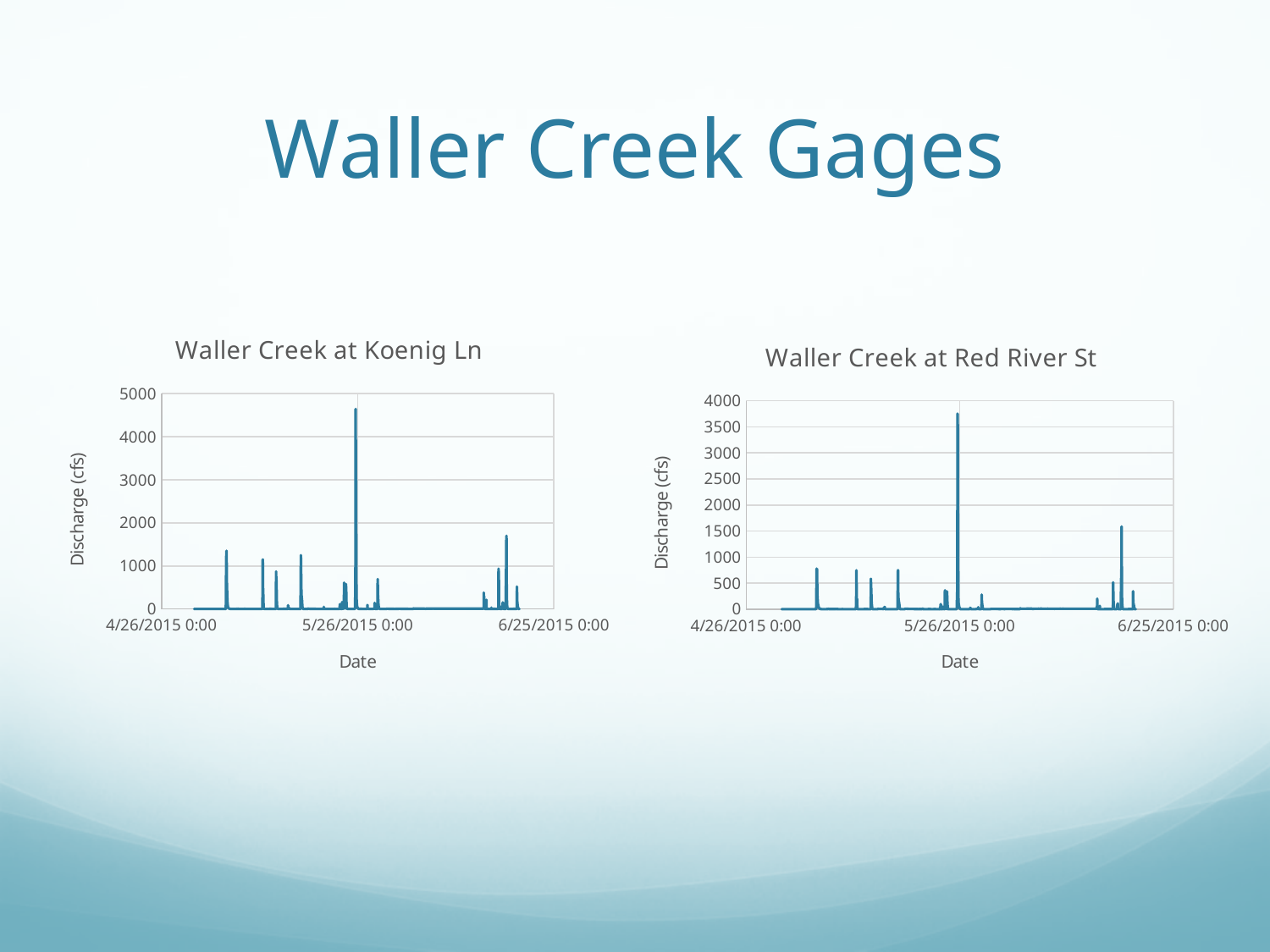
What kind of chart is "Waller Creek at Red River St"? line chart In the "Waller Creek at Red River St" chart, is the highest discharge peak greater or less than 4000 cfs? less In the "Waller Creek at Koenig Ln" chart, is the discharge peak near 6/25/2015 greater or less than 2000 cfs? less In the "Waller Creek at Koenig Ln" chart, is the highest discharge peak greater or less than 4000 cfs? greater What kind of chart is "Waller Creek at Koenig Ln"? line chart Which chart shows the higher maximum discharge peak, "Waller Creek at Koenig Ln" or "Waller Creek at Red River St"? Waller Creek at Koenig Ln What is the maximum value shown on the y-axis of the "Waller Creek at Red River St" chart? 4000 What is the y-axis label on the "Waller Creek at Koenig Ln" chart? Discharge (cfs)